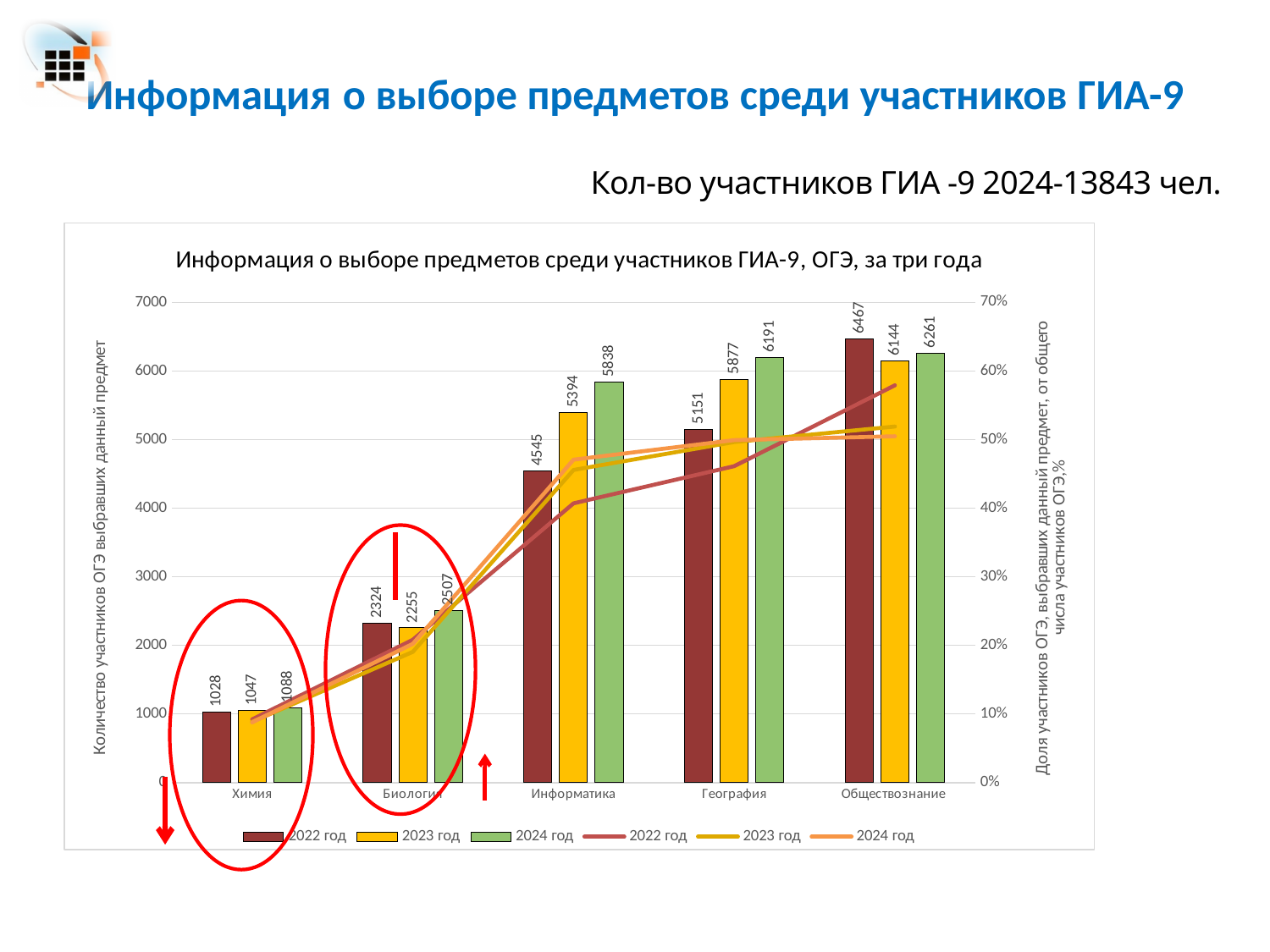
What is the value of the 2024 год bar for Информатика? 5838 Do the 2024 год bar values rise or fall from Химия to География? rise Which is larger for Биология: the 2022 год bar or the 2023 год bar? 2022 год What is the difference between the 2024 год and 2022 год bars for Информатика? 1293 What is the value of the 2023 год bar for Химия? 1047 How many series does the legend list? 6 Which subject has the highest 2024 год bar? Обществознание What is the value of the 2022 год bar for Обществознание? 6467 Which subject has the lowest 2022 год bar? Химия What is the title of the chart? Информация о выборе предметов среди участников ГИА-9, ОГЭ, за три года Is the 2022 год line value for Обществознание greater or less than 50%? greater How many subjects are shown on the x axis? 5